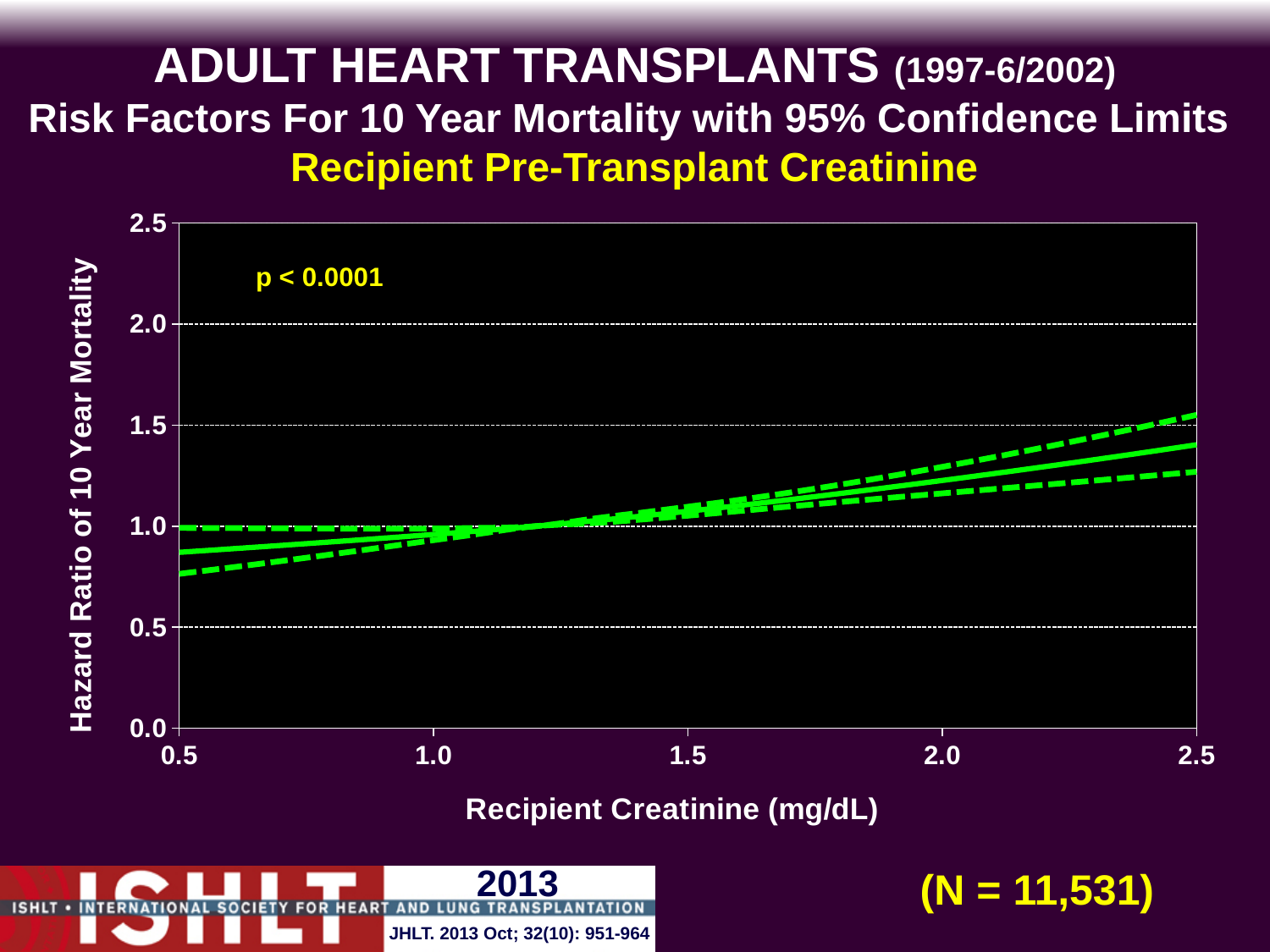
Is the hazard ratio (solid line) higher at a recipient creatinine of 2.5 mg/dL or at 0.5 mg/dL? 2.5 mg/dL What is the highest value shown on the y axis of the chart? 2.5 Is the hazard ratio (solid line) at a recipient creatinine of 0.5 mg/dL greater or less than 1.0? less What p-value is printed on the chart? p < 0.0001 Is the lower 95% confidence limit (lower dashed line) at a recipient creatinine of 0.5 mg/dL greater or less than 0.5? greater Is the hazard ratio (solid line) at a recipient creatinine of 2.5 mg/dL greater or less than 1.0? greater Does the hazard ratio of 10 year mortality rise or fall as recipient creatinine increases from 0.5 to 2.5 mg/dL? rise How many lines are plotted on the chart? 3 What kind of chart is shown on the slide? line chart